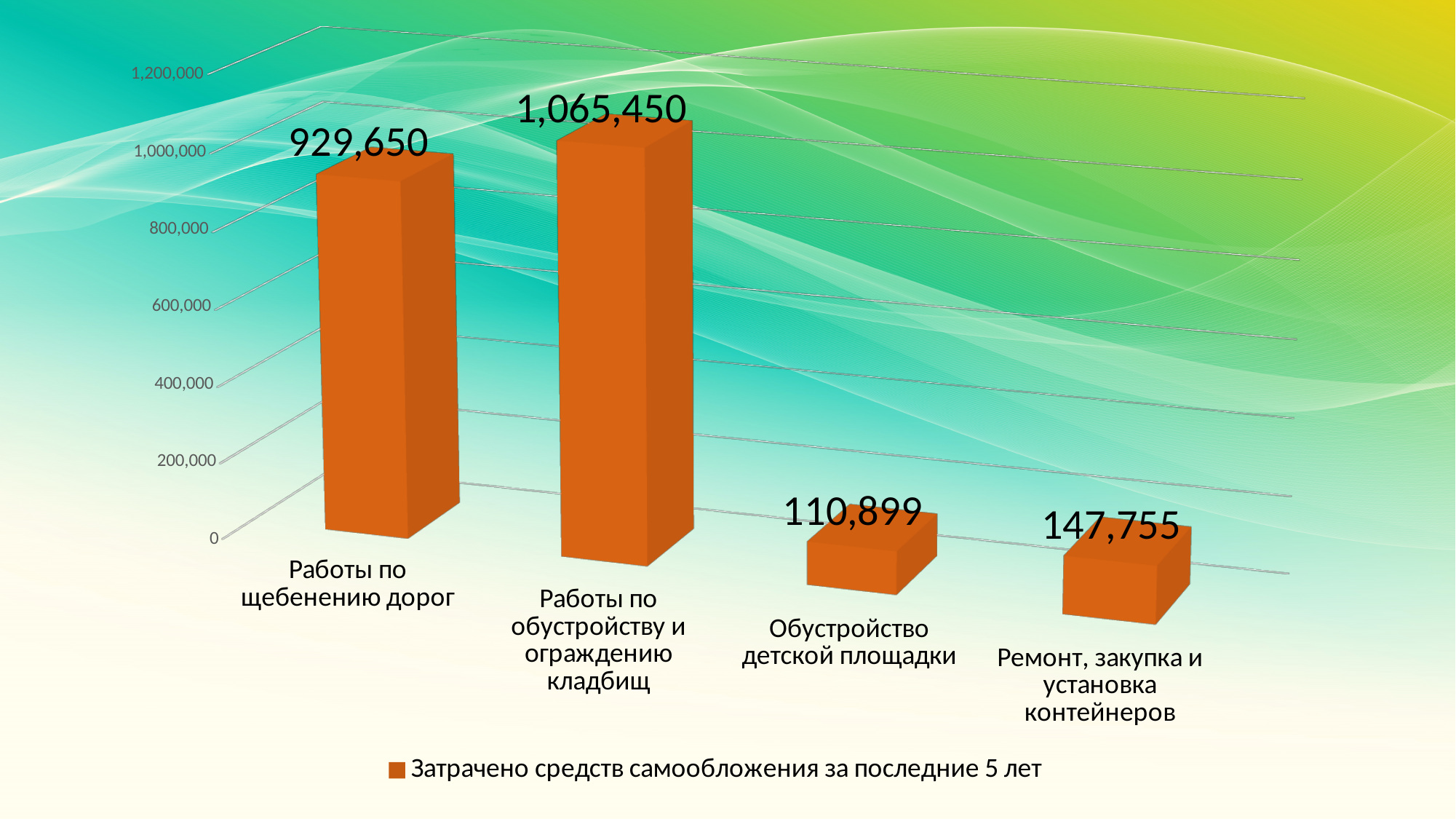
Which category has the lowest value? Обустройство детской площадки What is the value for "Обустройство детской площадки"? 110,899 Which category has the highest value? Работы по обустройству и ограждению кладбищ What kind of chart is shown on the slide? Bar chart How many categories are shown in the chart? 4 Which is larger: the value for "Работы по щебенению дорог" or the value for "Ремонт, закупка и установка контейнеров"? Работы по щебенению дорог What is the value for "Работы по обустройству и ограждению кладбищ"? 1,065,450 What is the value for "Ремонт, закупка и установка контейнеров"? 147,755 Is the value for "Работы по щебенению дорог" greater or less than 800,000? greater What is the difference between the values for "Ремонт, закупка и установка контейнеров" and "Обустройство детской площадки"? 36,856 What is the value for "Работы по щебенению дорог"? 929,650 What is the difference between the values for "Работы по обустройству и ограждению кладбищ" and "Работы по щебенению дорог"? 135,800